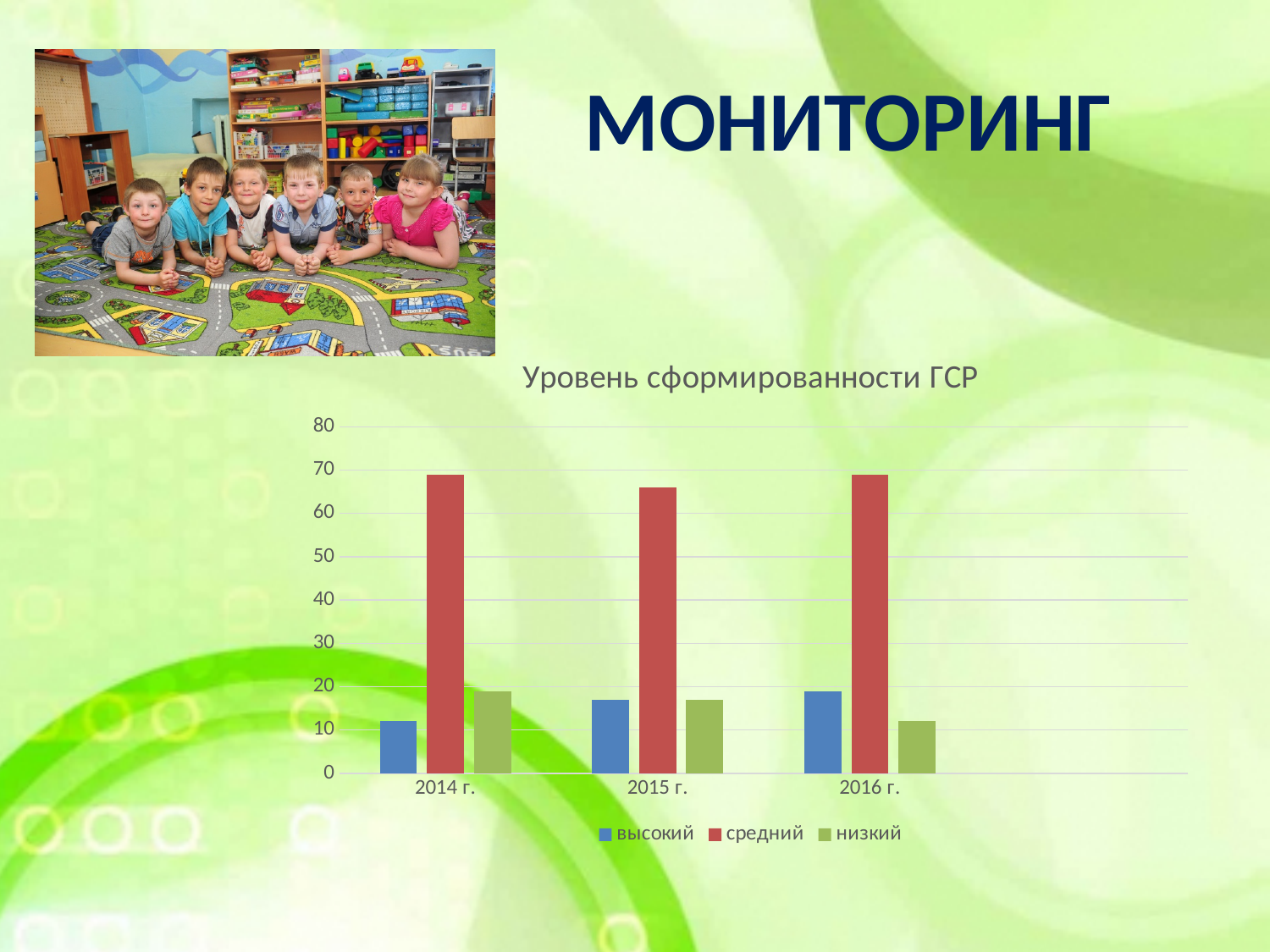
Is the value for высокий in 2014 г. greater or less than 20? less Is the value for низкий in 2014 г. greater or less than 30? less Which series is shown in red in the legend? средний Which series has the lowest value in 2014 г.? высокий How many series does the legend list? 3 Which series has the highest value in 2015 г.? средний Is the value for средний in 2015 г. greater or less than 50? greater What kind of chart is shown on the slide? bar chart In 2016 г., which is larger: средний or низкий? средний How many year categories are shown on the x axis? 3 What is the title of the chart? Уровень сформированности ГСР